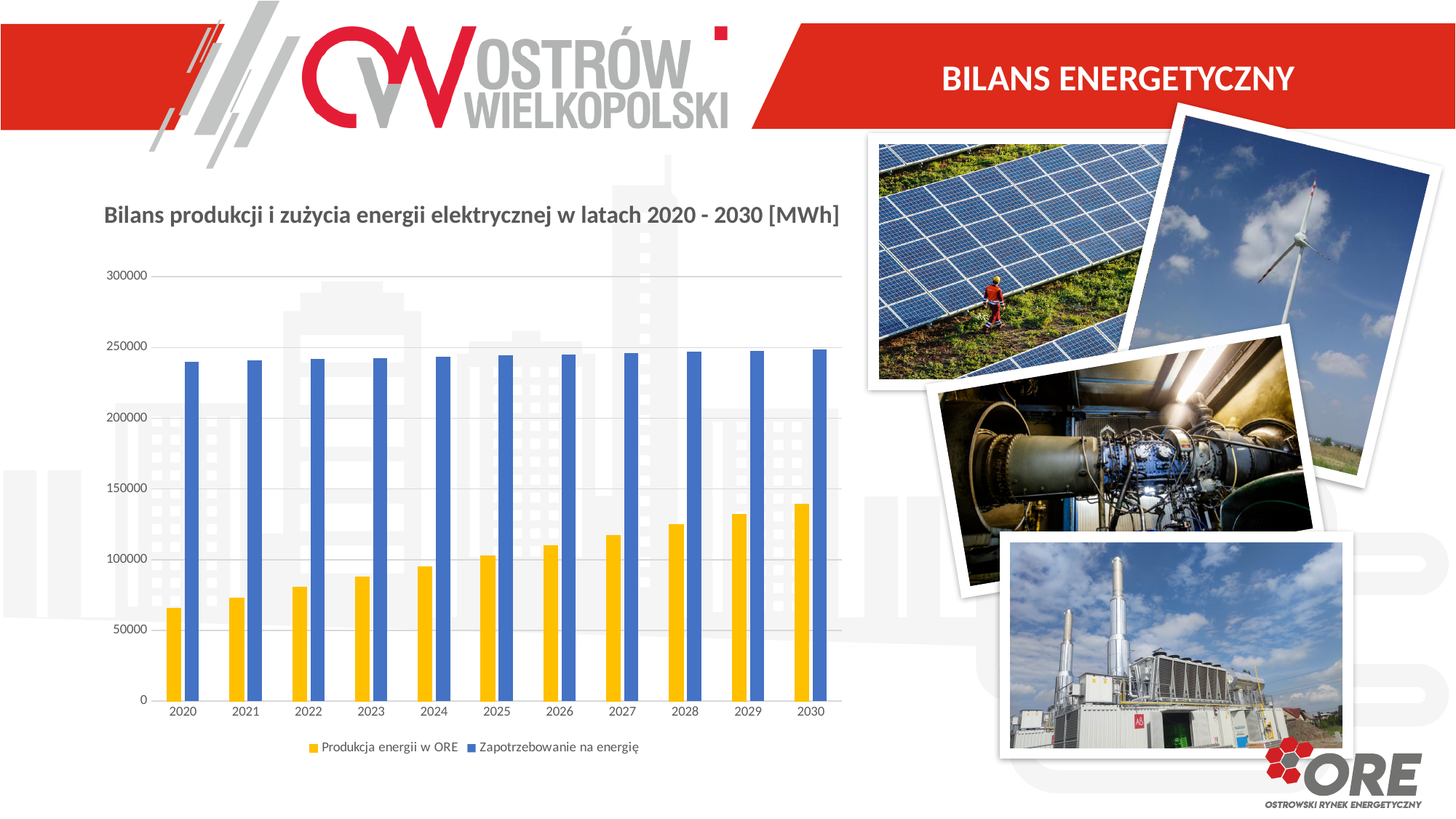
Is the value for Produkcja energii w ORE in 2020 greater or less than 100000? less How many years are shown on the x axis of the chart? 11 Which year has the lowest value for Produkcja energii w ORE? 2020 Which year has the highest value for Produkcja energii w ORE? 2030 What is the title of the chart? Bilans produkcji i zużycia energii elektrycznej w latach 2020 - 2030 [MWh] How many series does the chart legend list? 2 What kind of chart is shown on the slide? bar chart Do the values for Produkcja energii w ORE rise or fall from 2020 to 2030? rise Is the value for Produkcja energii w ORE in 2030 greater or less than 100000? greater Is the value for Zapotrzebowanie na energię in 2020 greater or less than 250000? less In 2025, which is larger: Produkcja energii w ORE or Zapotrzebowanie na energię? Zapotrzebowanie na energię